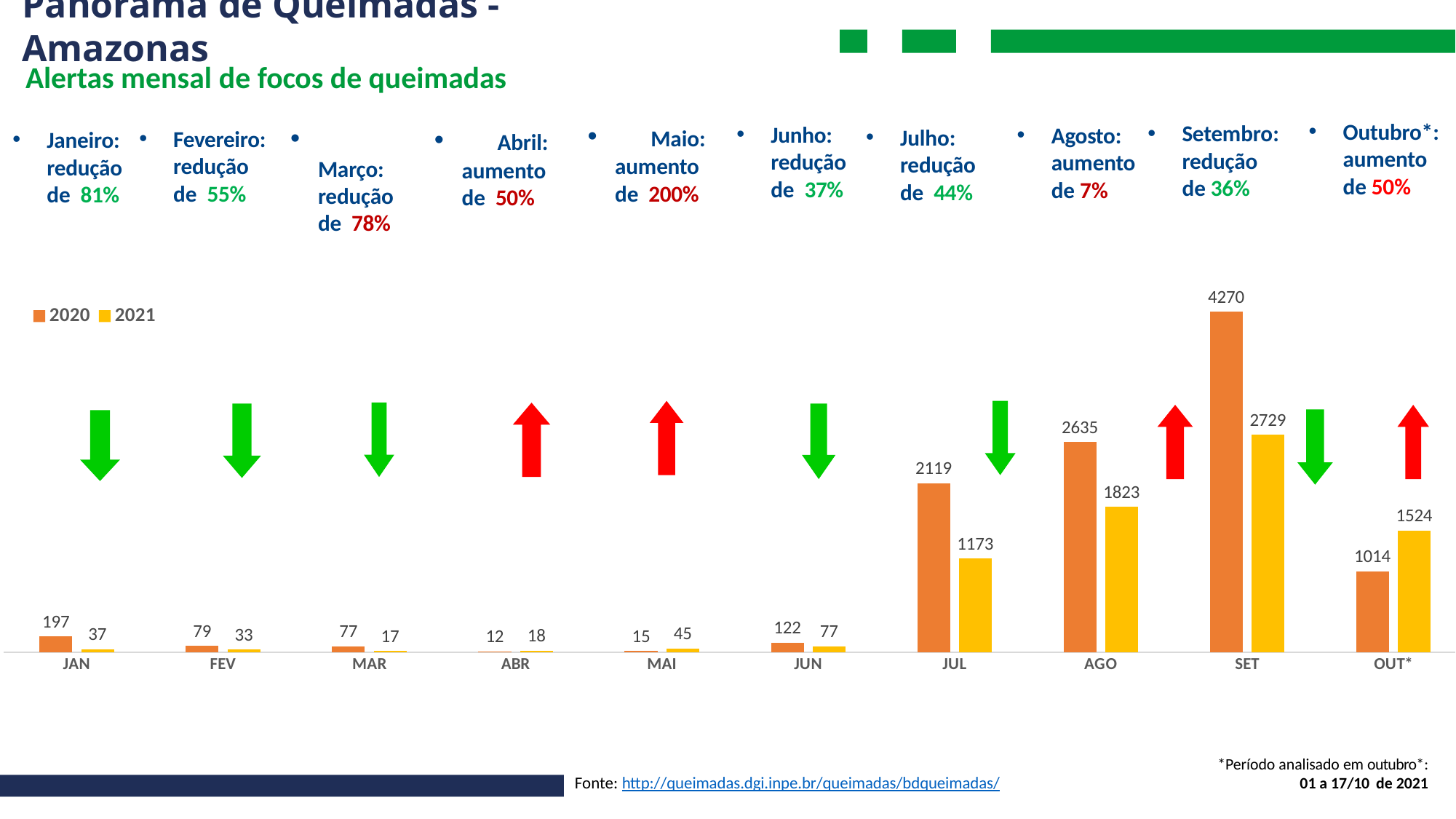
What is the 2021 value for OUT*? 1524 What is the difference between the 2020 and 2021 values for AGO? 812 What is the 2021 value for JUL? 1173 What kind of chart is shown on the slide? bar chart What is the 2020 value for SET? 4270 How many series does the legend list? 2 Which month has the lowest 2020 value? ABR What is the 2020 value for JAN? 197 What is the total of the 2020 and 2021 values for MAI? 60 Which is larger for OUT*, the 2020 value or the 2021 value? 2021 How many months are shown on the x axis? 10 Which month has the highest 2020 value? SET